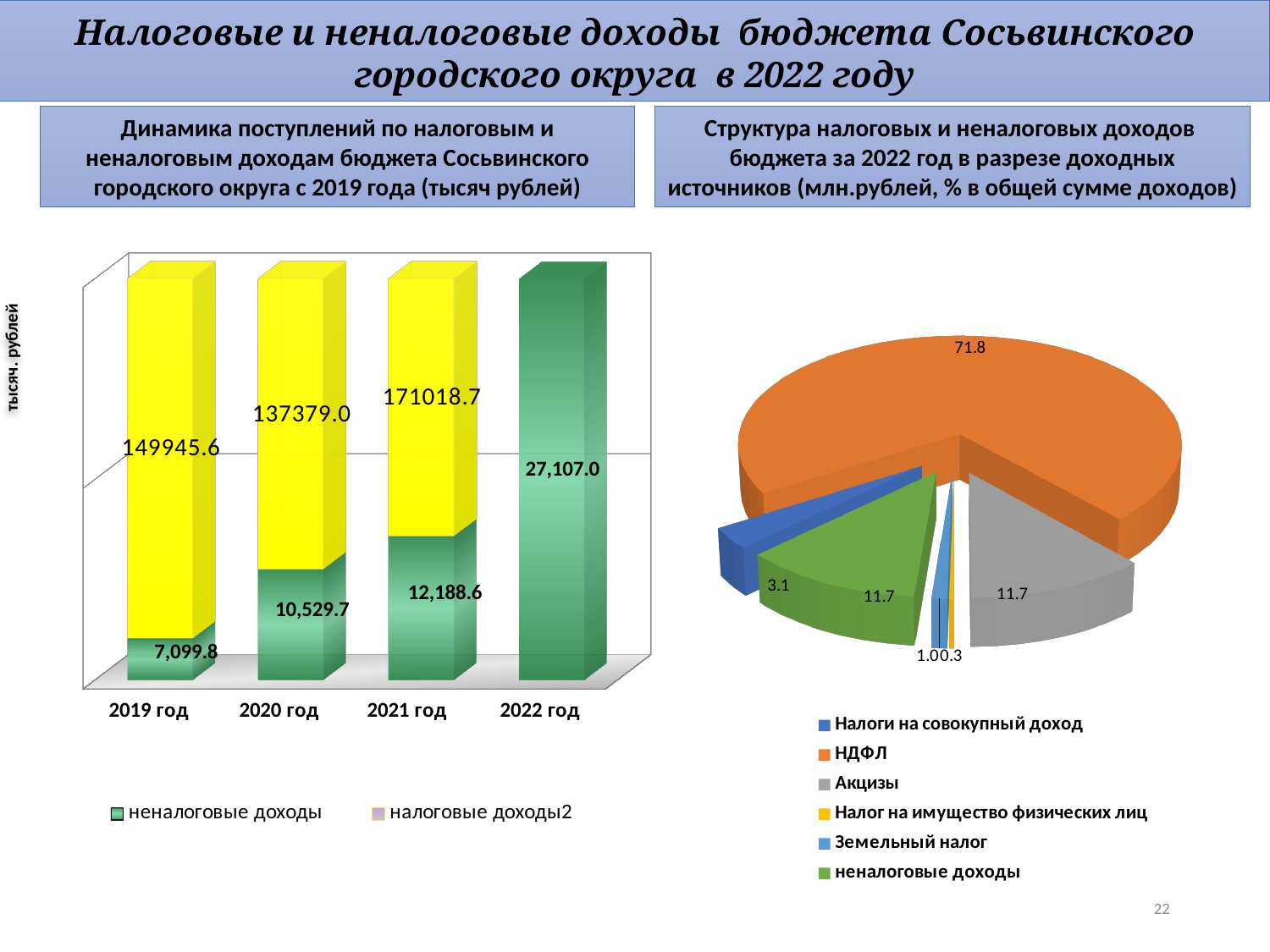
In the left chart (Динамика поступлений...), what is the value of неналоговые доходы for 2019 год? 7,099.8 In the left chart (Динамика поступлений...), what is the difference between неналоговые доходы in 2021 год and 2020 год? 1,658.9 In the left chart (Динамика поступлений...), what is the value of налоговые доходы2 for 2020 год? 137379.0 In the left chart (Динамика поступлений...), what value is labelled on the bar for 2022 год? 27,107.0 In the left chart (Динамика поступлений...), do the values of неналоговые доходы rise or fall from 2019 год to 2021 год? rise In the right chart (Структура налоговых и неналоговых доходов...), how many entries does the legend list? 6 In the left chart (Динамика поступлений...), how many series does the legend list? 2 What kind of chart is the left chart (Динамика поступлений...)? bar chart In the right chart (Структура налоговых и неналоговых доходов...), what is the value labelled for НДФЛ? 71.8 What kind of chart is the right chart (Структура налоговых и неналоговых доходов...)? pie chart In the left chart (Динамика поступлений...), how many year categories are shown on the x axis? 4